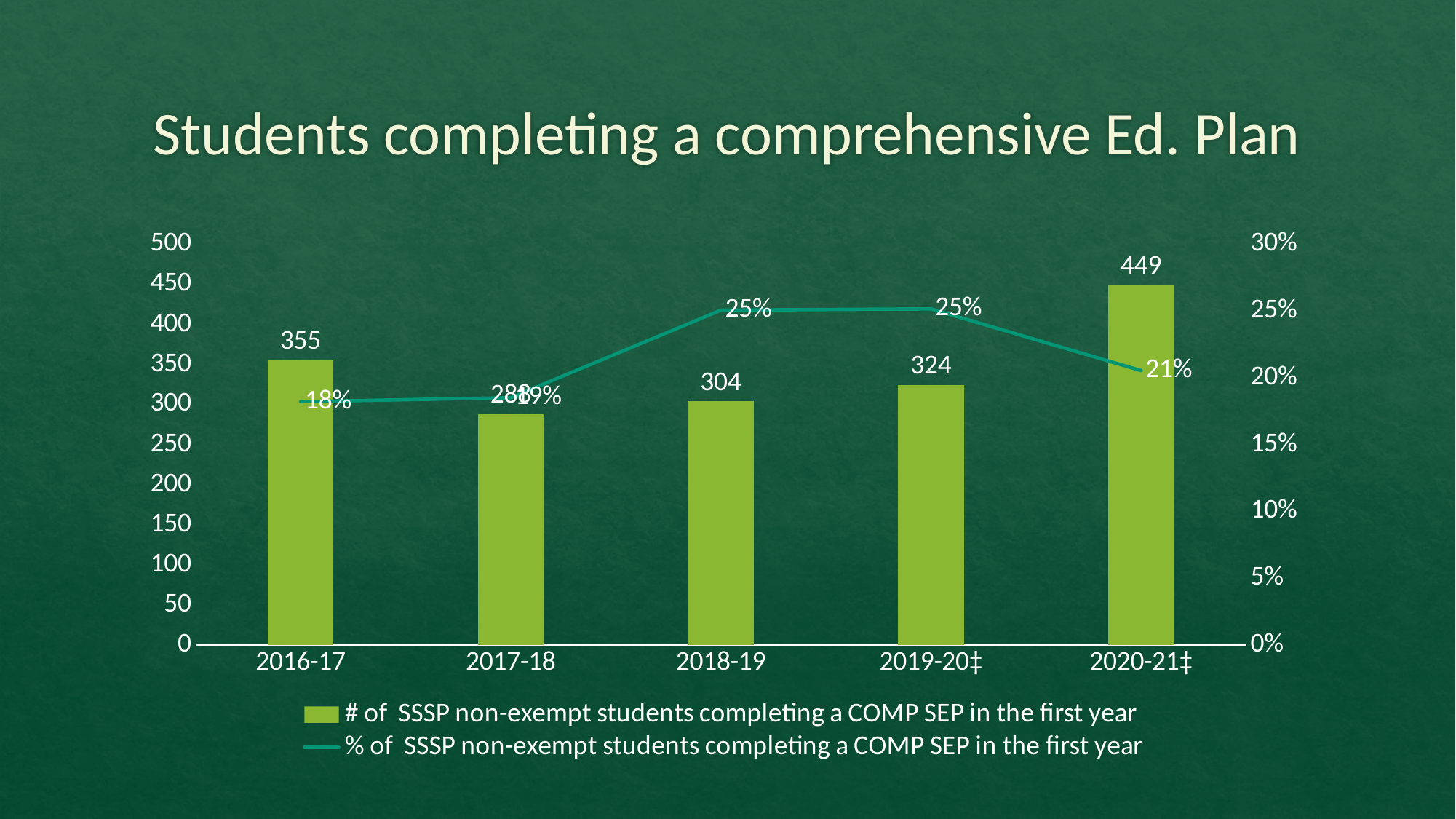
How many academic years are shown on the x axis? 5 What is the number of students completing a COMP SEP in the first year for 2020-21‡? 449 How many more students completed a COMP SEP in 2020-21‡ than in 2019-20‡? 125 What is the percentage value shown for 2020-21‡? 21% Which year has the highest number of students completing a COMP SEP in the first year? 2020-21‡ Is the number of students for 2017-18 greater or less than 350? less What percentage of SSSP non-exempt students completed a COMP SEP in the first year in 2018-19? 25% How many SSSP non-exempt students completed a COMP SEP in the first year in 2016-17? 355 What is the percentage value shown for 2016-17? 18% Which year has the lowest bar for number of students completing a COMP SEP? 2017-18 How many series does the legend list? 2 Which year had more students completing a COMP SEP: 2018-19 or 2019-20‡? 2019-20‡